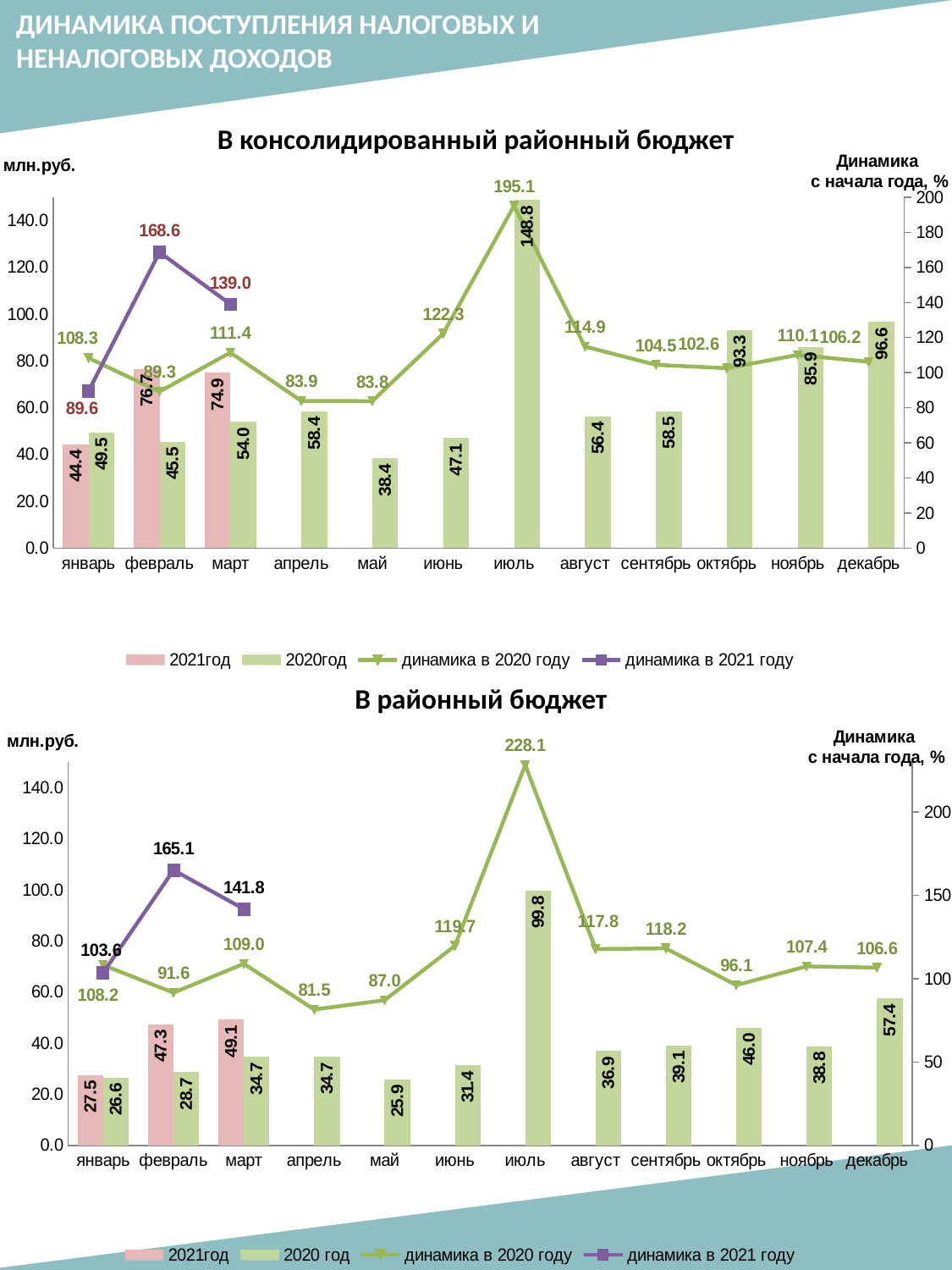
In the chart 'В консолидированный районный бюджет', what is the difference between the 2021год and 2020год bars for март? 20.9 In the chart 'В консолидированный районный бюджет', how many series does the legend list? 4 In the chart 'В районный бюджет', how many months are shown on the x axis? 12 In the chart 'В консолидированный районный бюджет', what is the value of the 2020 год bar for июль? 148.8 In the chart 'В районный бюджет', which is larger for январь: the 2021год bar or the 2020 год bar? 2021год In the chart 'В консолидированный районный бюджет', which month has the lowest 2020 год bar? май In the chart 'В консолидированный районный бюджет', what is the value of 'динамика в 2021 году' for февраль? 168.6 In the chart 'В районный бюджет', what is the value of the 2020 год bar for декабрь? 57.4 In the chart 'В районный бюджет', what is the highest value of 'динамика в 2020 году' and in which month? 228.1, июль What kind of chart is 'В районный бюджет'? Combined bar and line chart In the chart 'В районный бюджет', what is the value of 'динамика в 2021 году' for март? 141.8 In the chart 'В консолидированный районный бюджет', what is the value of the 2021год bar for февраль? 76.7